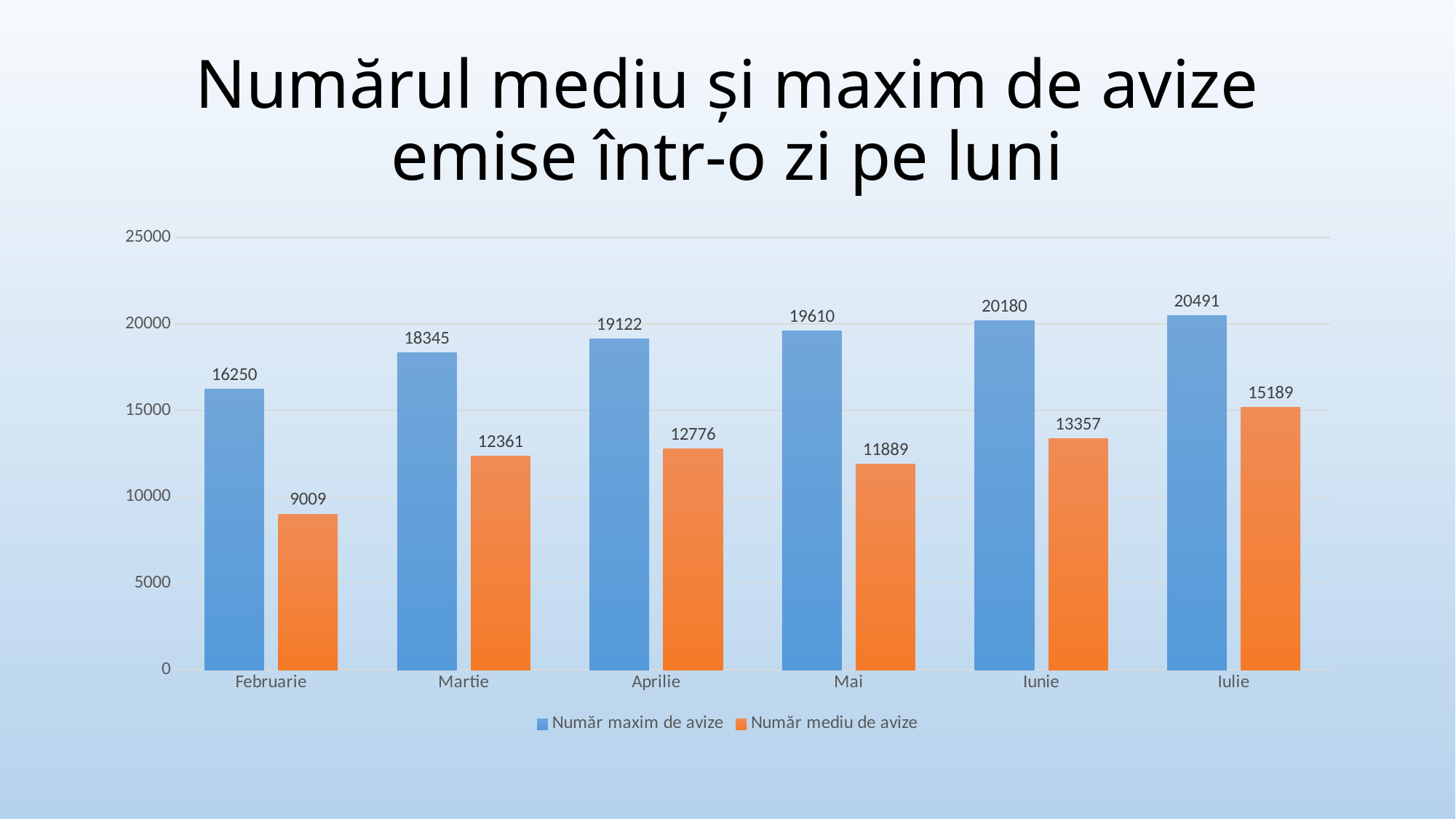
Is the value of Număr maxim de avize for Iunie greater or less than 20000? greater Which month has the lowest Număr mediu de avize? Februarie Which month has the highest Număr maxim de avize? Iulie What colour are the bars for Număr mediu de avize? orange What kind of chart is shown on the slide? bar chart What is the value of Număr mediu de avize for Iunie? 13357 Does Număr maxim de avize rise or fall from Februarie to Iulie? rise How many series does the legend list? 2 What is the difference between Număr maxim de avize and Număr mediu de avize for Februarie? 7241 What is the value of Număr maxim de avize for Martie? 18345 Which is larger: Număr mediu de avize for Aprilie or for Mai? Aprilie How many months are shown on the x axis? 6